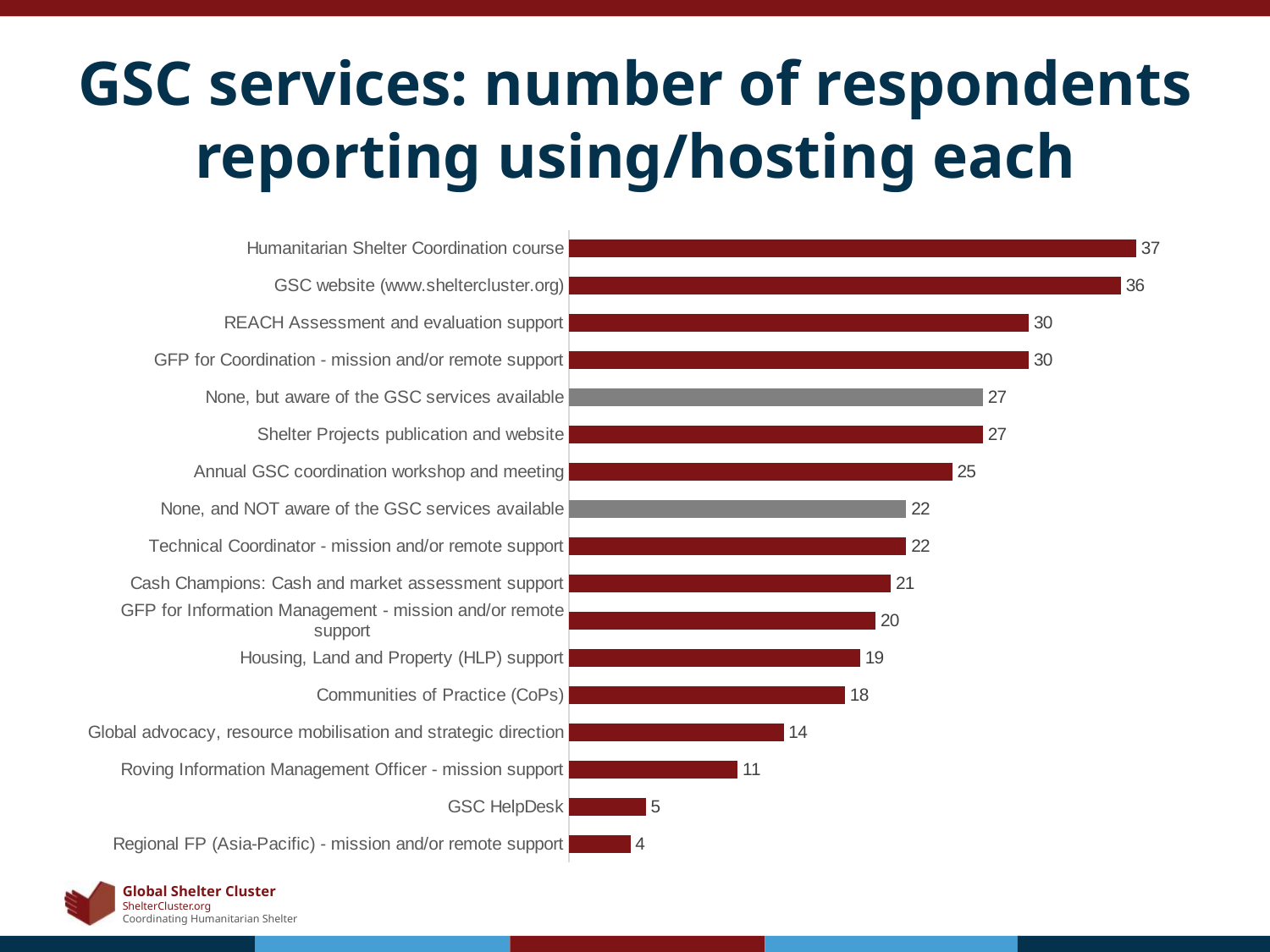
Which service has the highest number of respondents? Humanitarian Shelter Coordination course What is the difference between the values for Roving Information Management Officer - mission support and GSC HelpDesk? 6 What is the value for None, and NOT aware of the GSC services available? 22 What is the value for GSC HelpDesk? 5 Which category has the lowest value? Regional FP (Asia-Pacific) - mission and/or remote support What is the difference between the values for GSC website (www.sheltercluster.org) and Global advocacy, resource mobilisation and strategic direction? 22 What is the value for Communities of Practice (CoPs)? 18 Which two categories are shown with grey bars instead of dark red? None, but aware of the GSC services available; None, and NOT aware of the GSC services available Which is larger: the value for Annual GSC coordination workshop and meeting or the value for Housing, Land and Property (HLP) support? Annual GSC coordination workshop and meeting How many categories are plotted in the chart? 17 How many respondents reported using the Humanitarian Shelter Coordination course? 37 What type of chart is shown on the slide? bar chart